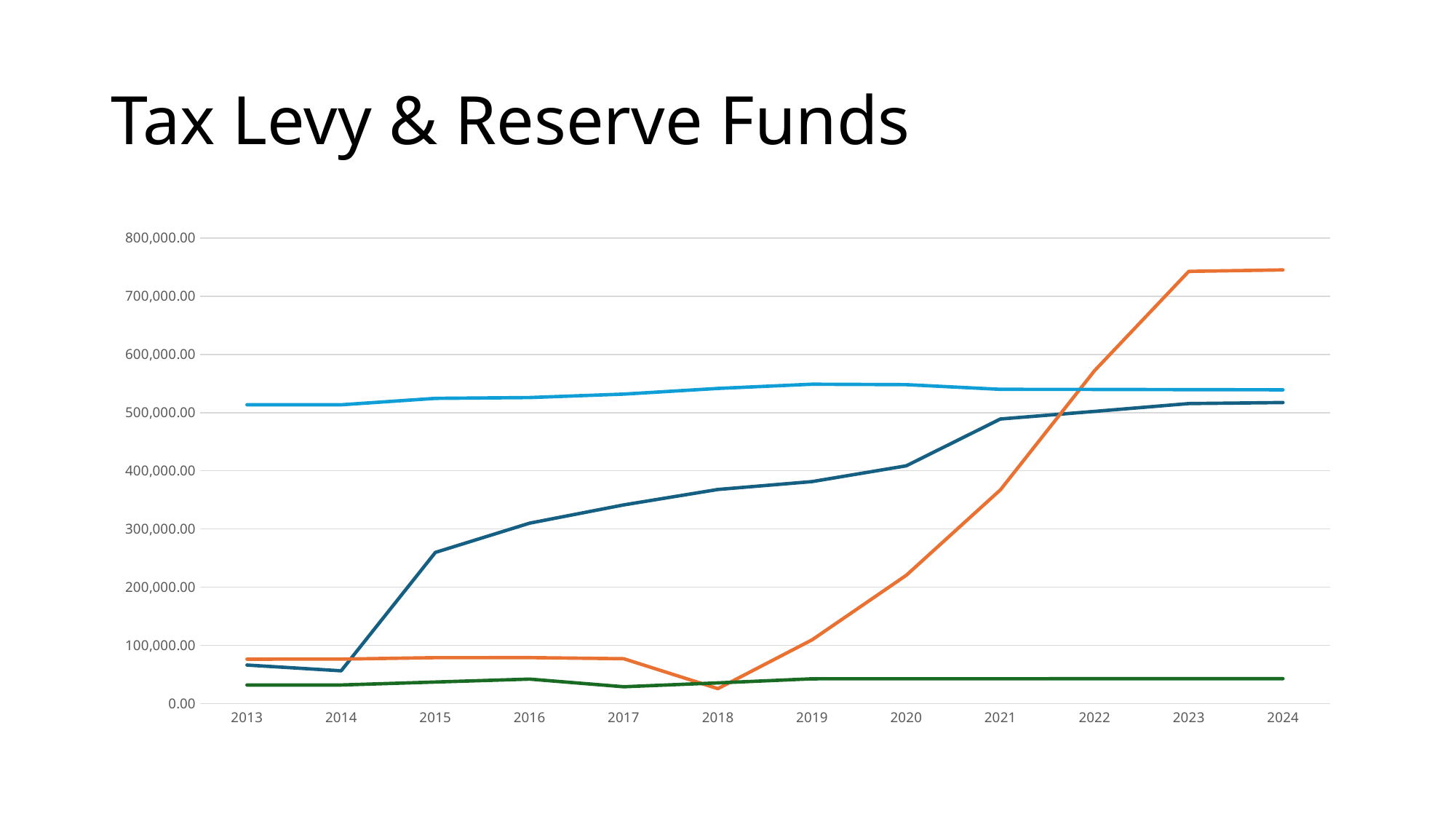
In 2024, which is higher: the orange line or the light blue line? the orange line Which line has the highest value in 2024? the orange line Is the value of the dark blue line in 2013 greater or less than 100,000? less Which line has the lowest value in 2024? the dark green line Does the dark blue line rise or fall from 2014 to 2024? rise Is the value of the orange line in 2024 greater or less than 700,000? greater Is the value of the light blue line in 2019 greater or less than 500,000? greater What is the title of the chart on the slide? Tax Levy & Reserve Funds In 2013, which is higher: the light blue line or the orange line? the light blue line How many years are shown along the x axis of the chart? 12 What kind of chart is shown on the slide? line chart